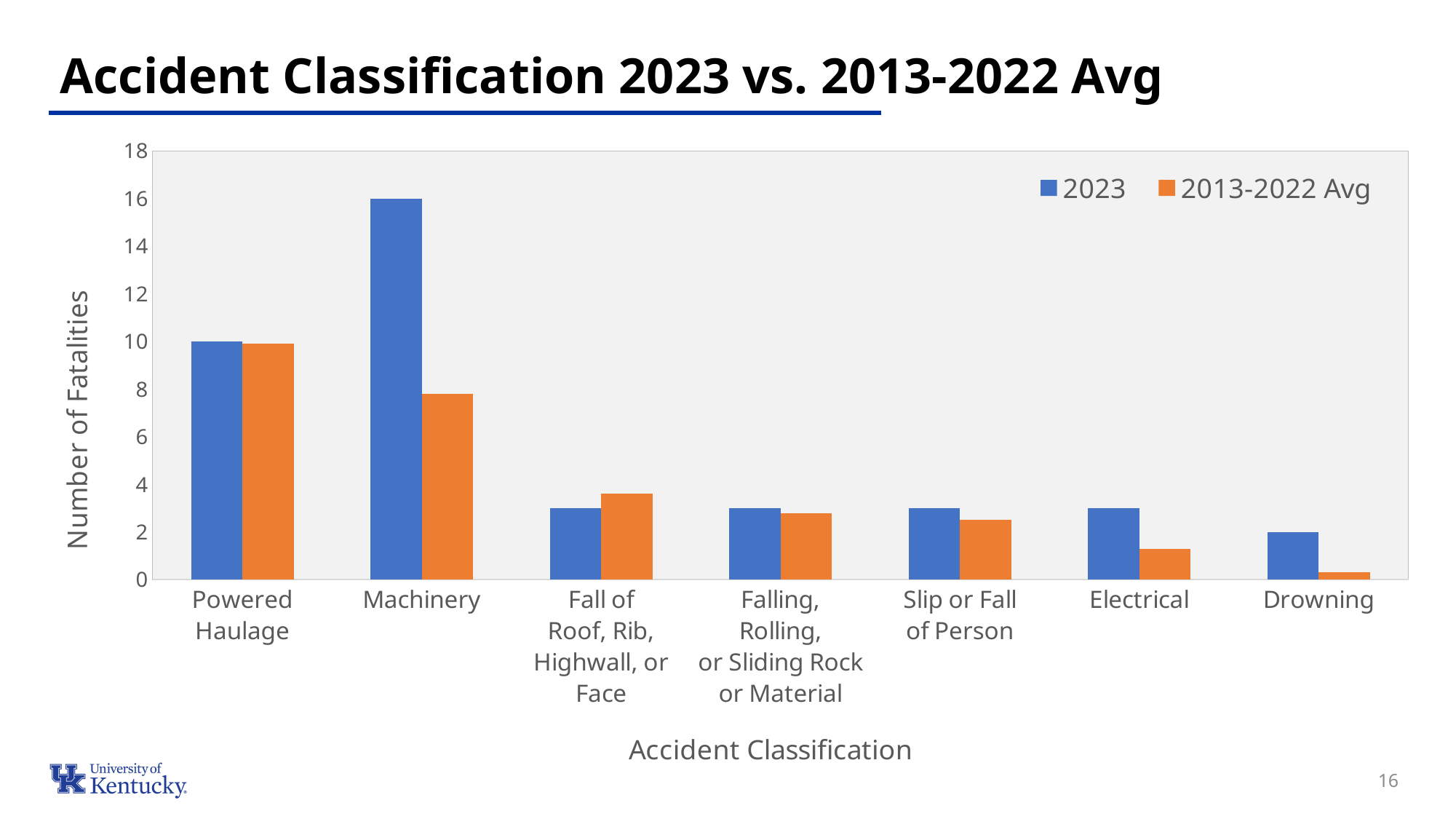
Which accident classification has the highest 2023 value? Machinery Is the 2013-2022 Avg value for Machinery greater or less than 10? less For Machinery, which is larger: the 2023 value or the 2013-2022 Avg value? 2023 What is the 2023 value for Powered Haulage? 10 How many series does the legend list? 2 What is the 2023 value for Drowning? 2 Is the 2013-2022 Avg value for Electrical greater or less than 2? less How many accident classifications are shown on the x axis? 7 What is the 2023 value for Machinery? 16 What is the difference between the 2023 values for Machinery and Powered Haulage? 6 Which accident classification has the lowest 2023 value? Drowning For Electrical, which is larger: the 2023 value or the 2013-2022 Avg value? 2023